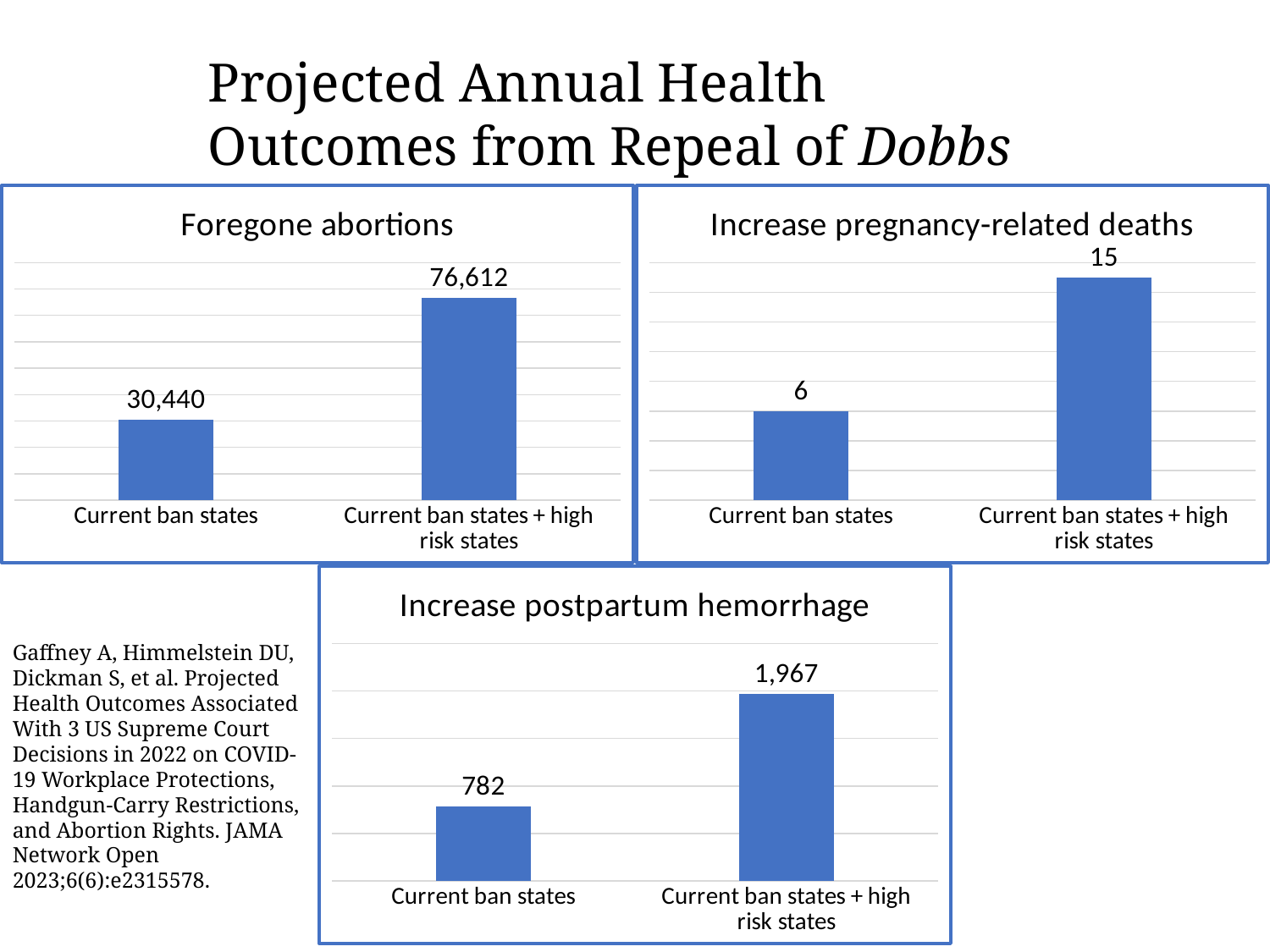
In the 'Increase pregnancy-related deaths' chart, what is the value for Current ban states? 6 What type of chart is the 'Increase pregnancy-related deaths' chart? Bar chart In the 'Increase postpartum hemorrhage' chart, what is the value for Current ban states? 782 In the 'Foregone abortions' chart, what is the difference between the two bars? 46,172 In the 'Foregone abortions' chart, what is the value for Current ban states? 30,440 In the 'Foregone abortions' chart, what is the value for Current ban states + high risk states? 76,612 In the 'Increase pregnancy-related deaths' chart, what is the value for Current ban states + high risk states? 15 In the 'Increase postpartum hemorrhage' chart, what is the value for Current ban states + high risk states? 1,967 How many categories are shown in the 'Foregone abortions' chart? 2 In the 'Increase postpartum hemorrhage' chart, which category has the higher value? Current ban states + high risk states In the 'Increase pregnancy-related deaths' chart, what is the difference between the two bars? 9 In the 'Increase postpartum hemorrhage' chart, what is the difference between the two bars? 1,185